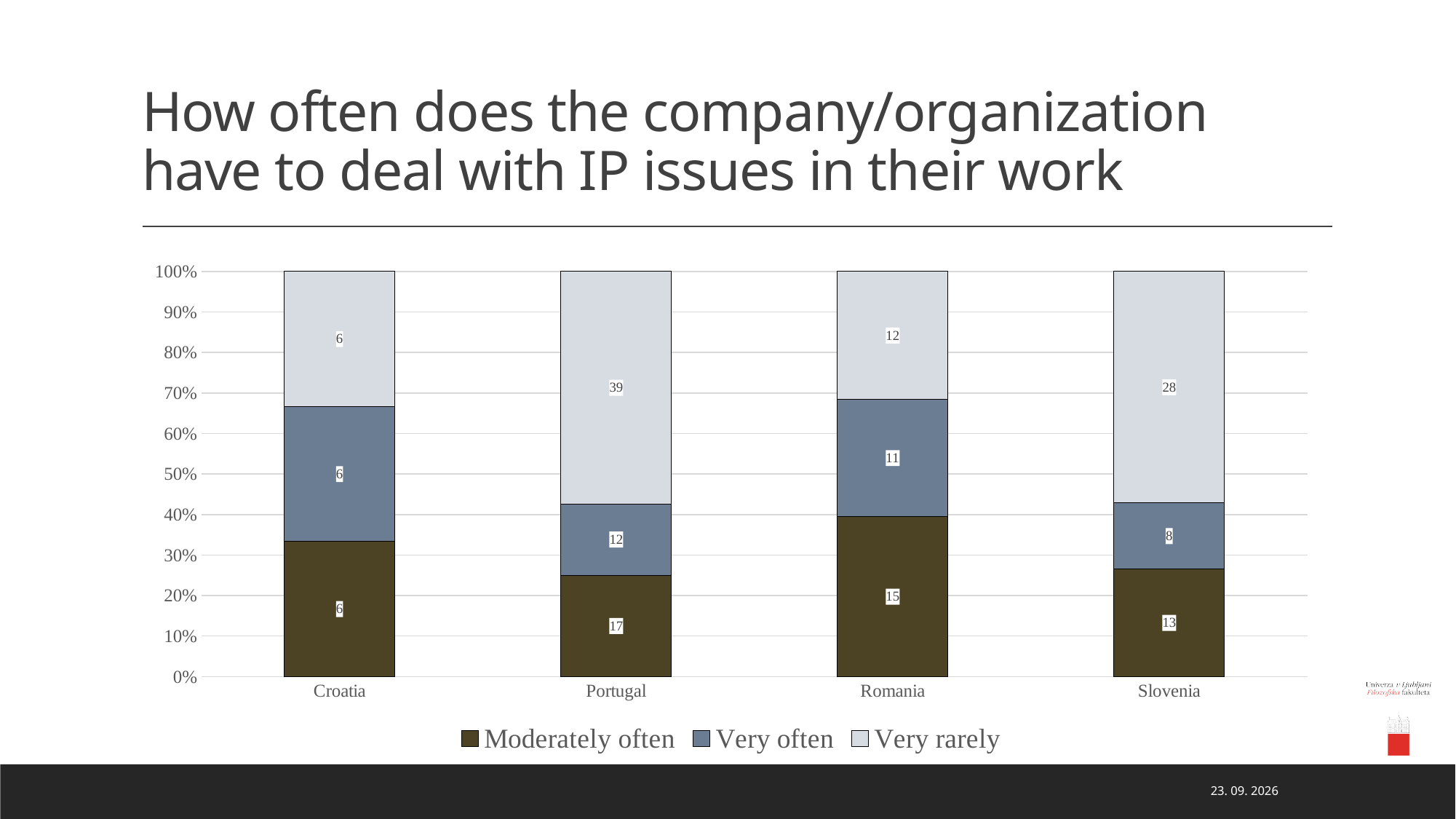
How many series does the legend list? 3 What is the total of the three values in the Slovenia bar? 49 What kind of chart is shown on the slide? stacked bar chart Which legend entry is shown in the lightest colour? Very rarely Which is larger, the 'Very often' value for Portugal or for Romania? Portugal Which country has the lowest 'Moderately often' value? Croatia What is the 'Moderately often' value for Romania? 15 Which country has the highest 'Very rarely' value? Portugal What is the difference between the 'Very rarely' values for Portugal and Slovenia? 11 What is the 'Very rarely' value for Portugal? 39 How many countries are shown on the x axis? 4 What is the 'Very often' value for Slovenia? 8